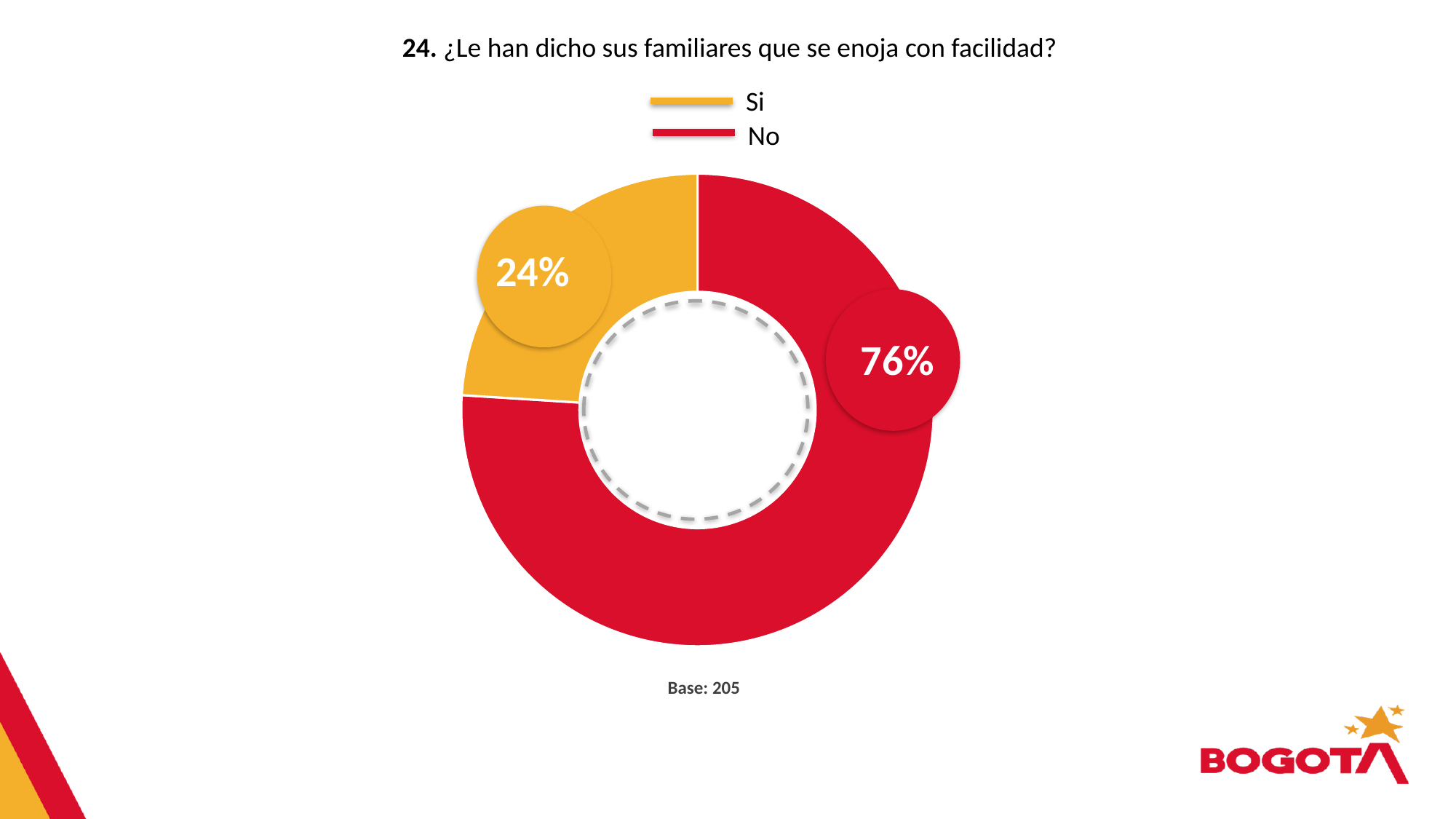
What percentage of respondents answered "Si"? 24% What is the difference in percentage points between the "No" and "Si" responses? 52 How many entries does the legend list? 2 How many categories are shown in the chart? 2 Which colour represents the "Si" response in the chart? Yellow/orange Which is larger, the share for "Si" or the share for "No"? No What percentage of respondents answered "No"? 76% What kind of chart is shown on the slide? Pie chart (doughnut) What is the base (number of respondents) shown below the chart? 205 Which response has the largest share of the chart? No What is the combined total of the "Si" and "No" shares? 100% Which response has the smallest share of the chart? Si